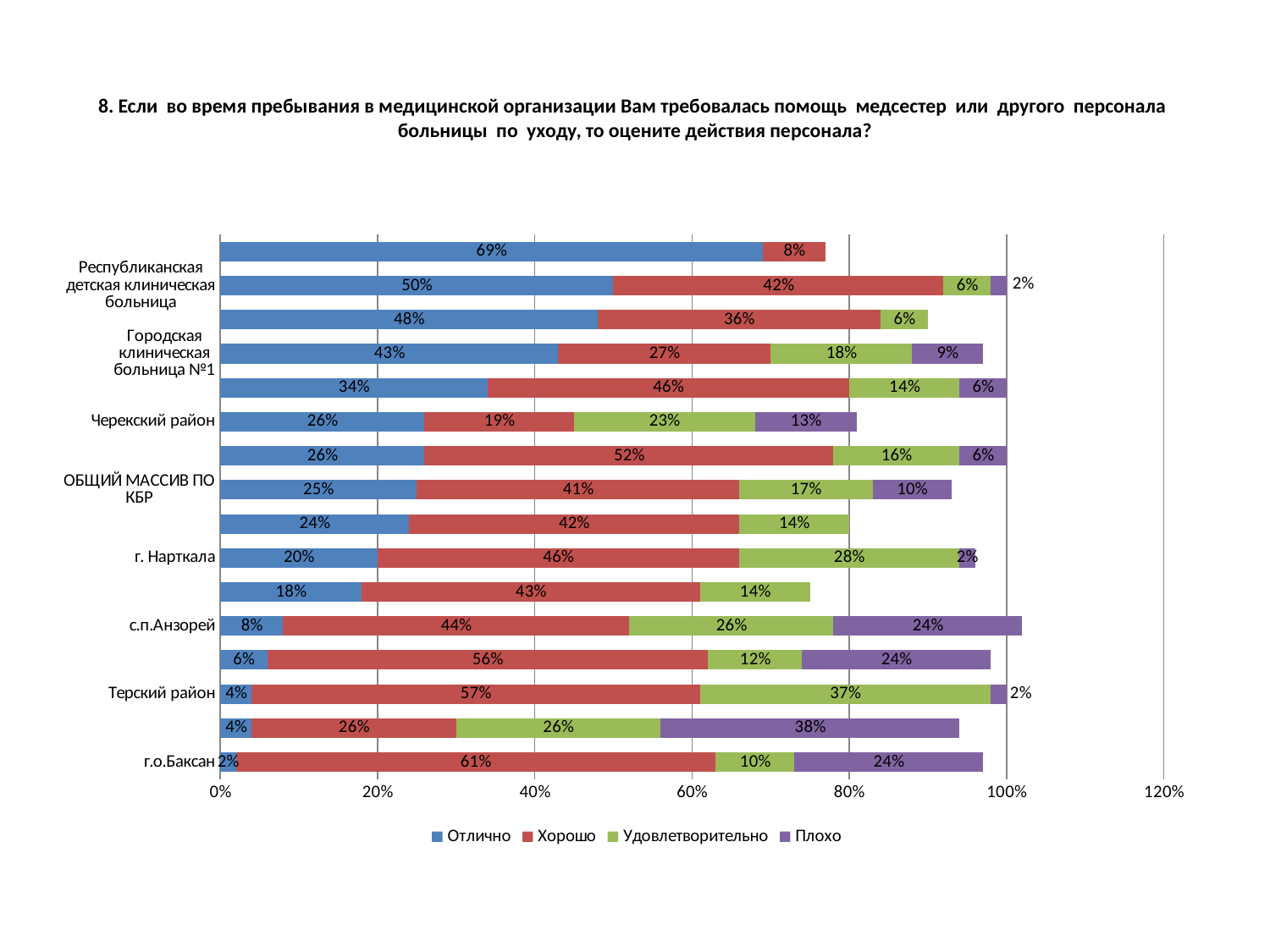
What is the difference between Хорошо and Отлично for ОБЩИЙ МАССИВ ПО КБР? 16% What is the value of Плохо for с.п.Анзорей? 24% What kind of chart is shown on the slide? bar chart What is the total of the stacked bar for Городская клиническая больница №1? 97% What is the value of Отлично for Черекский район? 26% What is the value of Удовлетворительно for Терский район? 37% What is the value of Удовлетворительно for г. Нарткала? 28% What are the four legend entries of the chart? Отлично, Хорошо, Удовлетворительно, Плохо How many series does the legend list? 4 Is the total length of the stacked bar for Черекский район greater or less than 100%? less What is the value of Хорошо for г.о.Баксан? 61% Which has a larger Отлично value: Республиканская детская клиническая больница or Городская клиническая больница №1? Республиканская детская клиническая больница